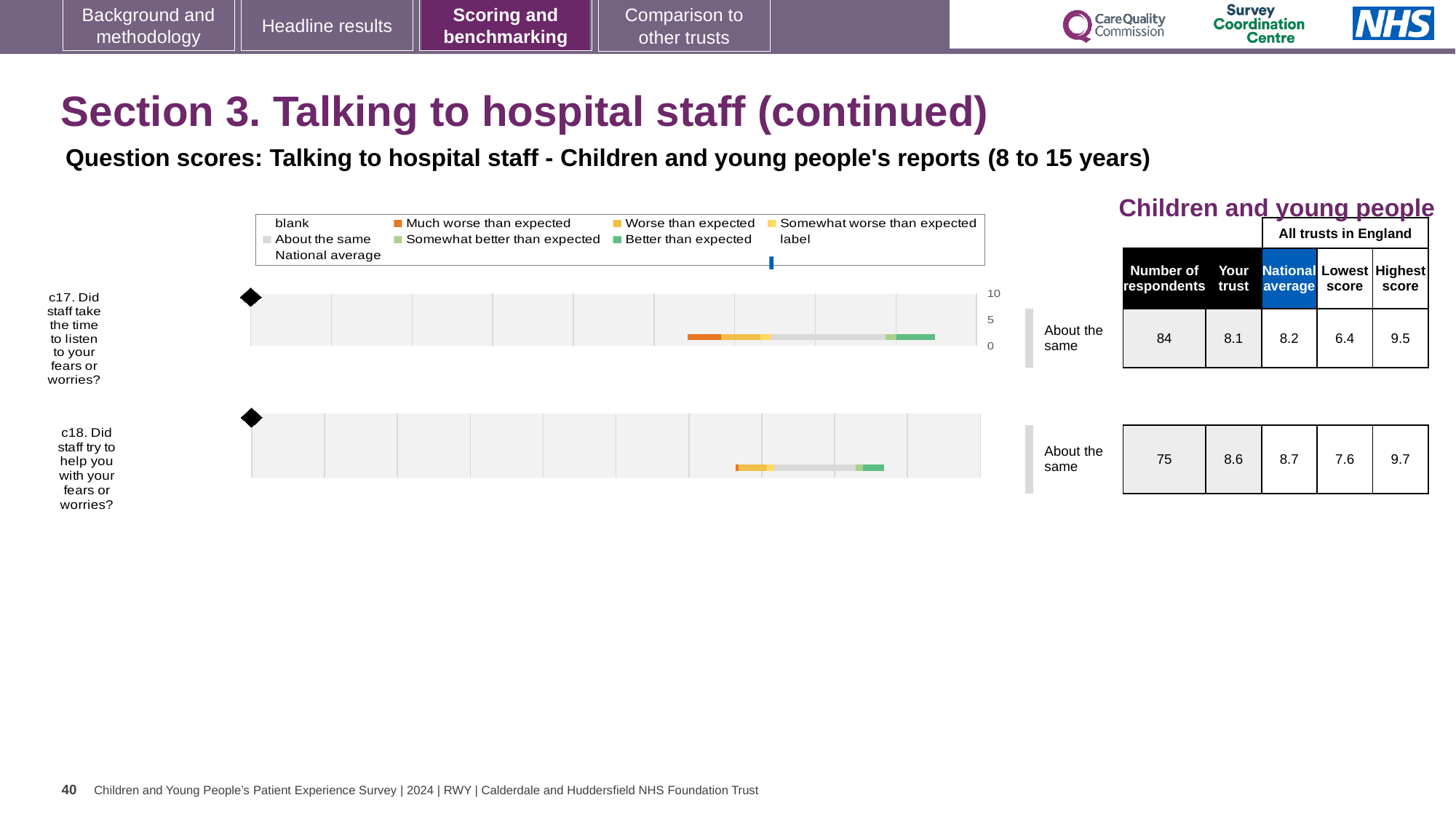
Is the trust's score for c17 greater or less than 5 on the chart axis? greater What type of chart is used to show the question scores for c17 and c18? bar chart How many respondents answered c18? 75 What is the difference between the highest score and the lowest score for c18? 2.1 What benchmark category is shown for c18? About the same What is the difference between the highest score and the lowest score for c17? 3.1 What is the national average score for c17? 8.2 What is the trust's score for c18 (Did staff try to help you with your fears or worries?)? 8.6 Which question has the higher trust score, c17 or c18? c18 What is the trust's score for c17 (Did staff take the time to listen to your fears or worries?)? 8.1 How many questions (c17 and c18) are plotted on the slide? 2 For c17, which is larger: the trust's score or the national average? National average